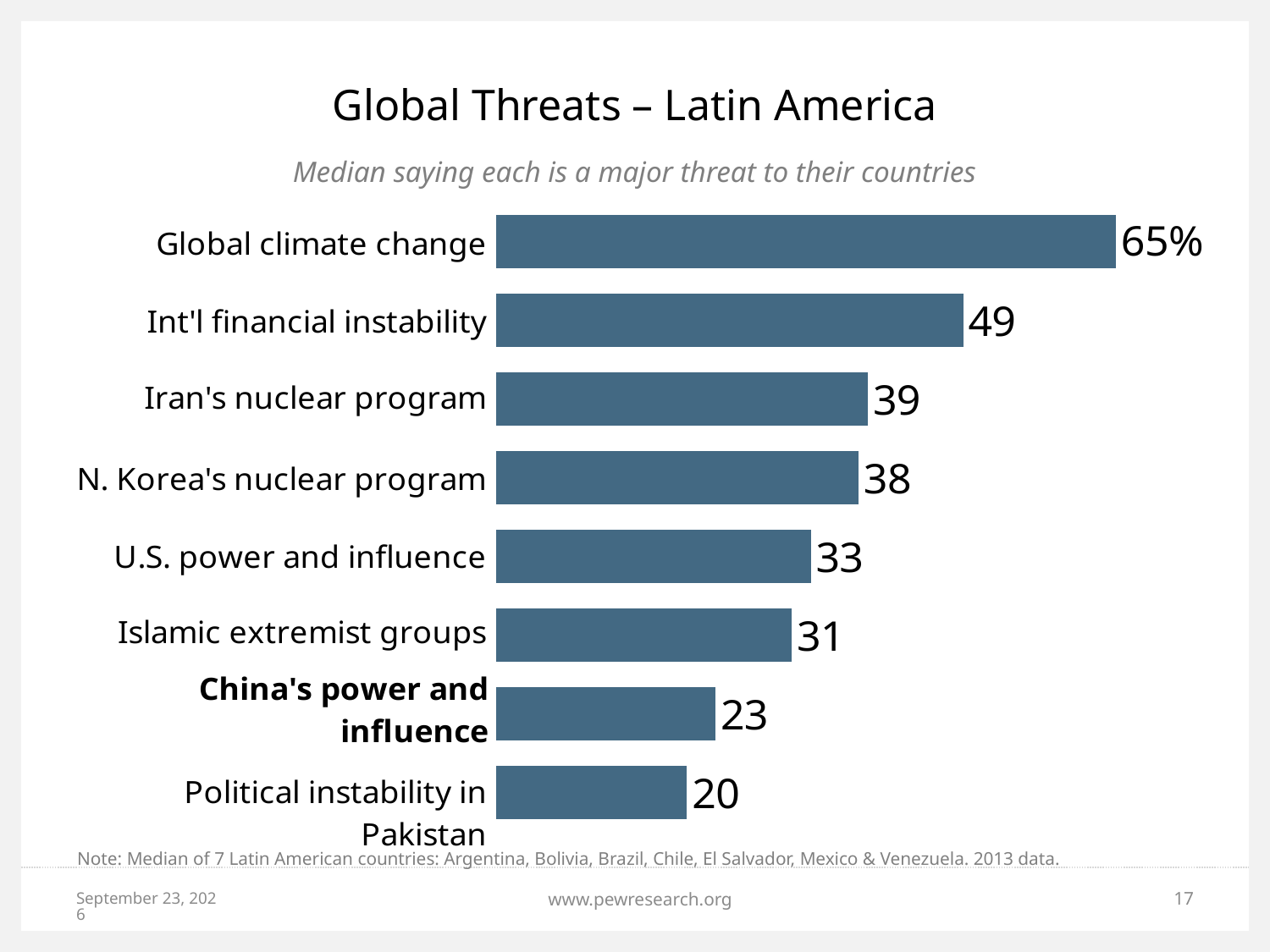
What is the subtitle of the chart? Median saying each is a major threat to their countries What is the value for U.S. power and influence? 33 What is the value for Int'l financial instability? 49 What is the difference between the values for Islamic extremist groups and China's power and influence? 8 How many categories are shown in the chart? 8 What is the value for China's power and influence? 23 Which category has the highest value? Global climate change Which category has the lowest value? Political instability in Pakistan What is the difference between the values for Global climate change and Int'l financial instability? 16 What kind of chart is shown on the slide? Bar chart What is the value for Global climate change? 65% Which is larger, the value for Iran's nuclear program or the value for U.S. power and influence? Iran's nuclear program